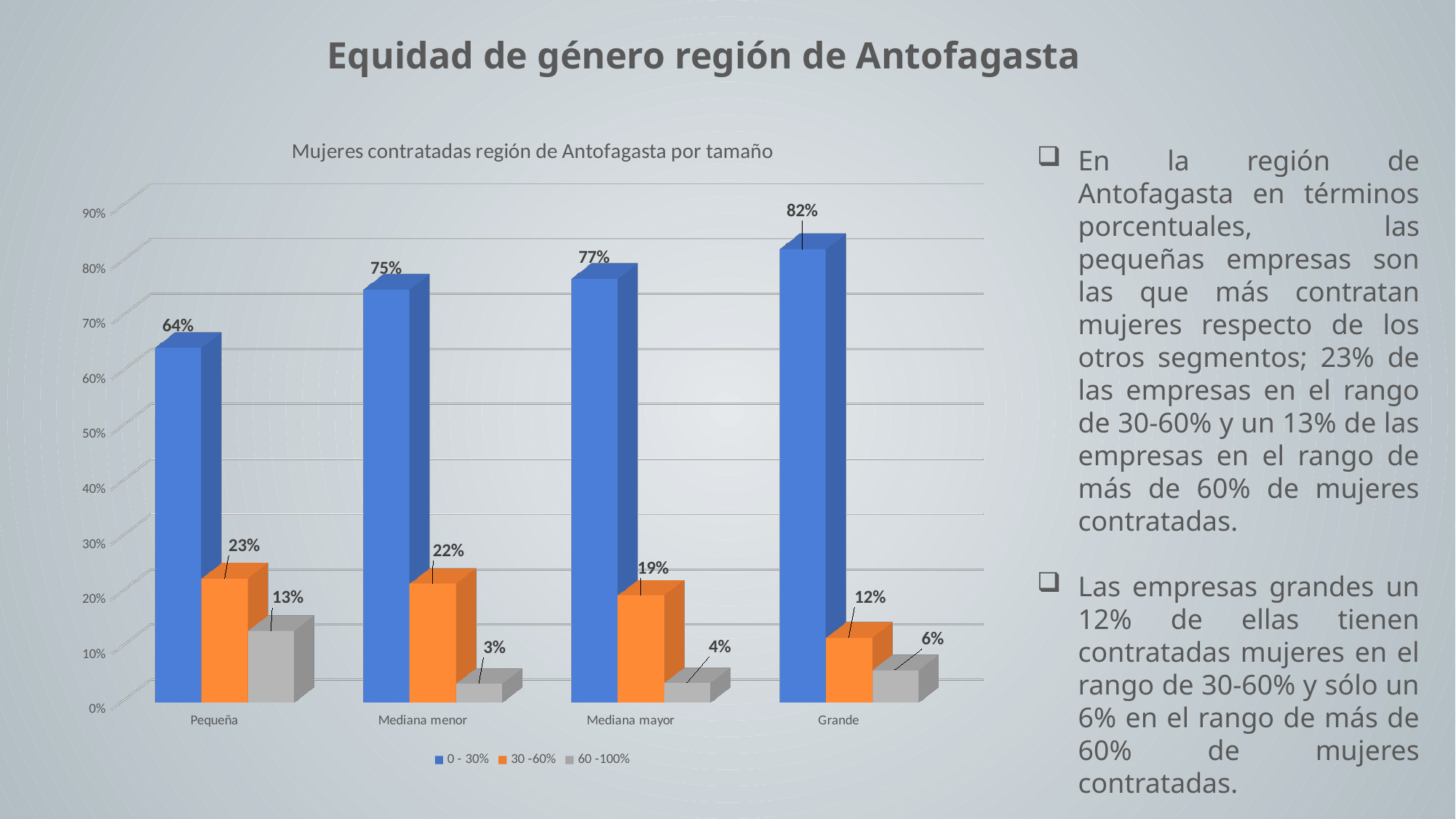
Which is larger: the 30 -60% value for Mediana mayor or for Grande? Mediana mayor What is the title of the chart? Mujeres contratadas región de Antofagasta por tamaño Which category has the highest value in the 0 - 30% series? Grande What is the value of the 60 -100% series for Mediana menor? 3% What is the difference between the 0 - 30% values for Grande and Pequeña? 18% What kind of chart is shown? bar chart Is the 0 - 30% value for Mediana mayor greater or less than 70%? greater Which category has the lowest value in the 60 -100% series? Mediana menor What is the value of the 0 - 30% series for Grande? 82% How many categories are shown on the x axis? 4 What is the value of the 30 -60% series for Pequeña? 23% How many series does the legend list? 3